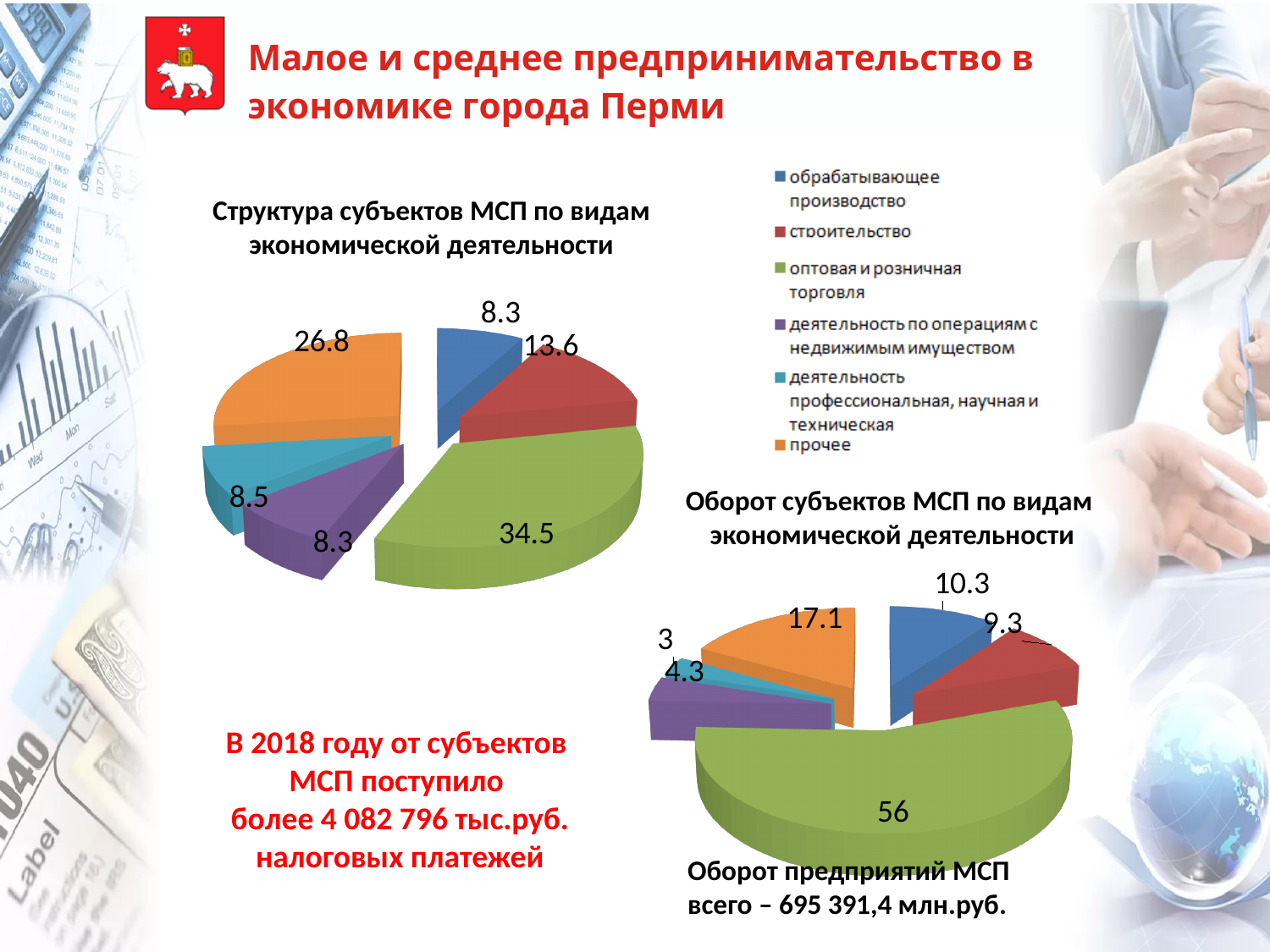
In the chart "Оборот субъектов МСП по видам экономической деятельности", what is the value for оптовая и розничная торговля? 56 In the chart "Структура субъектов МСП по видам экономической деятельности", what is the value for оптовая и розничная торговля? 34.5 In the chart "Оборот субъектов МСП по видам экономической деятельности", what is the difference between the values for обрабатывающее производство and строительство? 1 In the chart "Структура субъектов МСП по видам экономической деятельности", what is the value for строительство? 13.6 In the chart "Оборот субъектов МСП по видам экономической деятельности", which is larger: the value for прочее or the value for строительство? прочее In the chart "Структура субъектов МСП по видам экономической деятельности", what is the value for прочее? 26.8 What kind of chart is "Структура субъектов МСП по видам экономической деятельности"? Pie chart In the chart "Оборот субъектов МСП по видам экономической деятельности", what is the value for обрабатывающее производство? 10.3 In the chart "Оборот субъектов МСП по видам экономической деятельности", which category has the smallest slice? деятельность профессиональная, научная и техническая How many categories does the legend list for the pie charts? 6 In the chart "Структура субъектов МСП по видам экономической деятельности", which category has the largest slice? оптовая и розничная торговля In the chart "Структура субъектов МСП по видам экономической деятельности", what is the difference between the values for прочее and строительство? 13.2